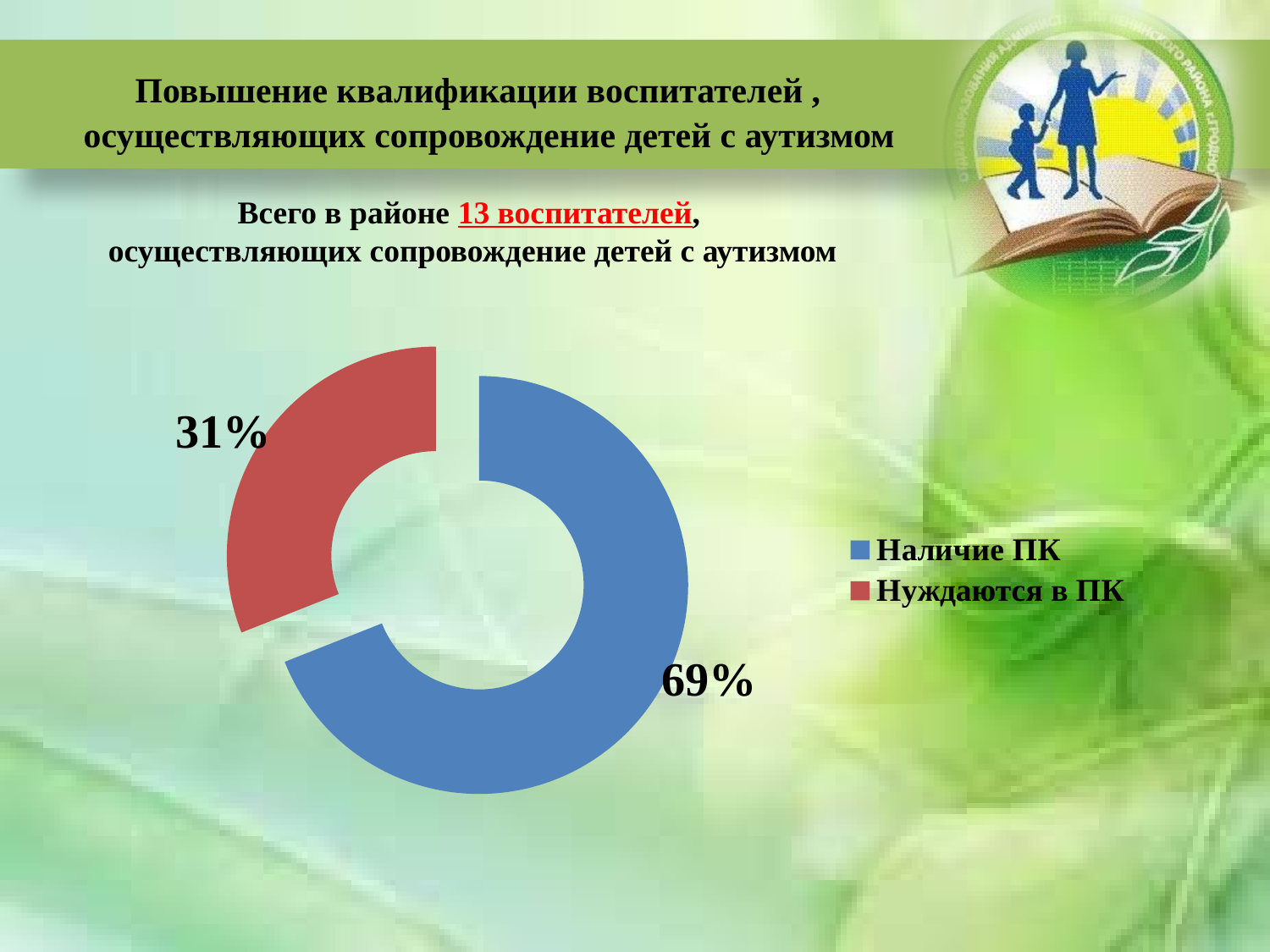
What is the difference in percentage points between "Наличие ПК" and "Нуждаются в ПК"? 38 percentage points How many categories does the chart show? 2 Which category has the largest share of the chart? Наличие ПК Which category has the smallest share of the chart? Нуждаются в ПК What kind of chart is shown on the slide? Doughnut (pie) chart What share of the chart does "Нуждаются в ПК" represent? 31% How many entries does the legend list? 2 What colour is the "Нуждаются в ПК" segment? Red What share of the chart does "Наличие ПК" represent? 69% What colour is the "Наличие ПК" segment? Blue Which is larger: the share for "Наличие ПК" or the share for "Нуждаются в ПК"? Наличие ПК